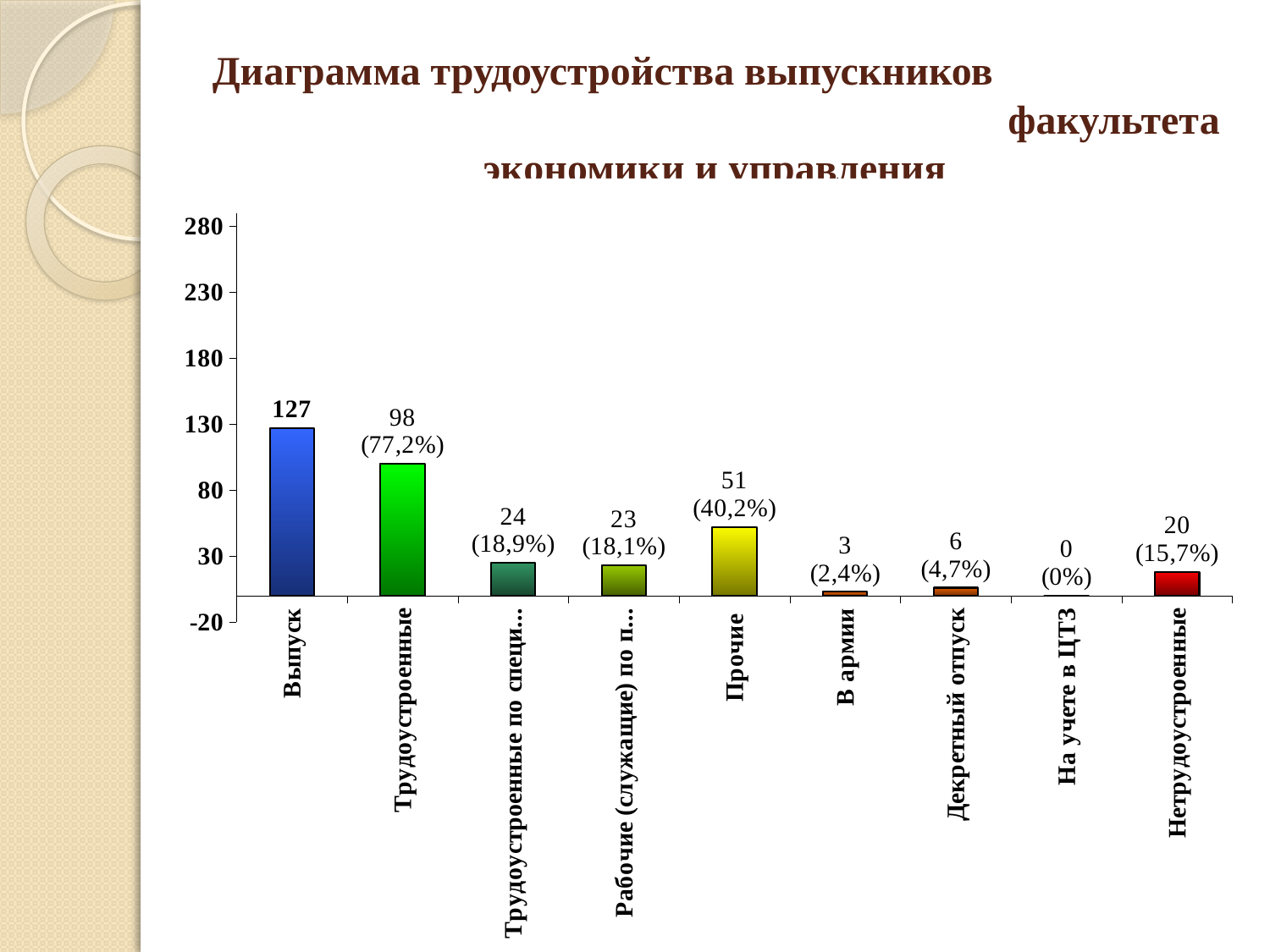
How many categories are shown on the x axis? 9 What is the value for Выпуск? 127 What is the value for В армии? 3 What percentage is shown for Декретный отпуск? 4,7% Which is larger, the value for Прочие or the value for Нетрудоустроенные? Прочие What is the difference between the values for Выпуск and Трудоустроенные? 29 What is the value for Трудоустроенные? 98 Which category has the highest value? Выпуск What is the value for Нетрудоустроенные? 20 Which category has the lowest value? На учете в ЦТЗ What percentage is shown for Прочие? 40,2% What kind of chart is shown on the slide? Bar chart